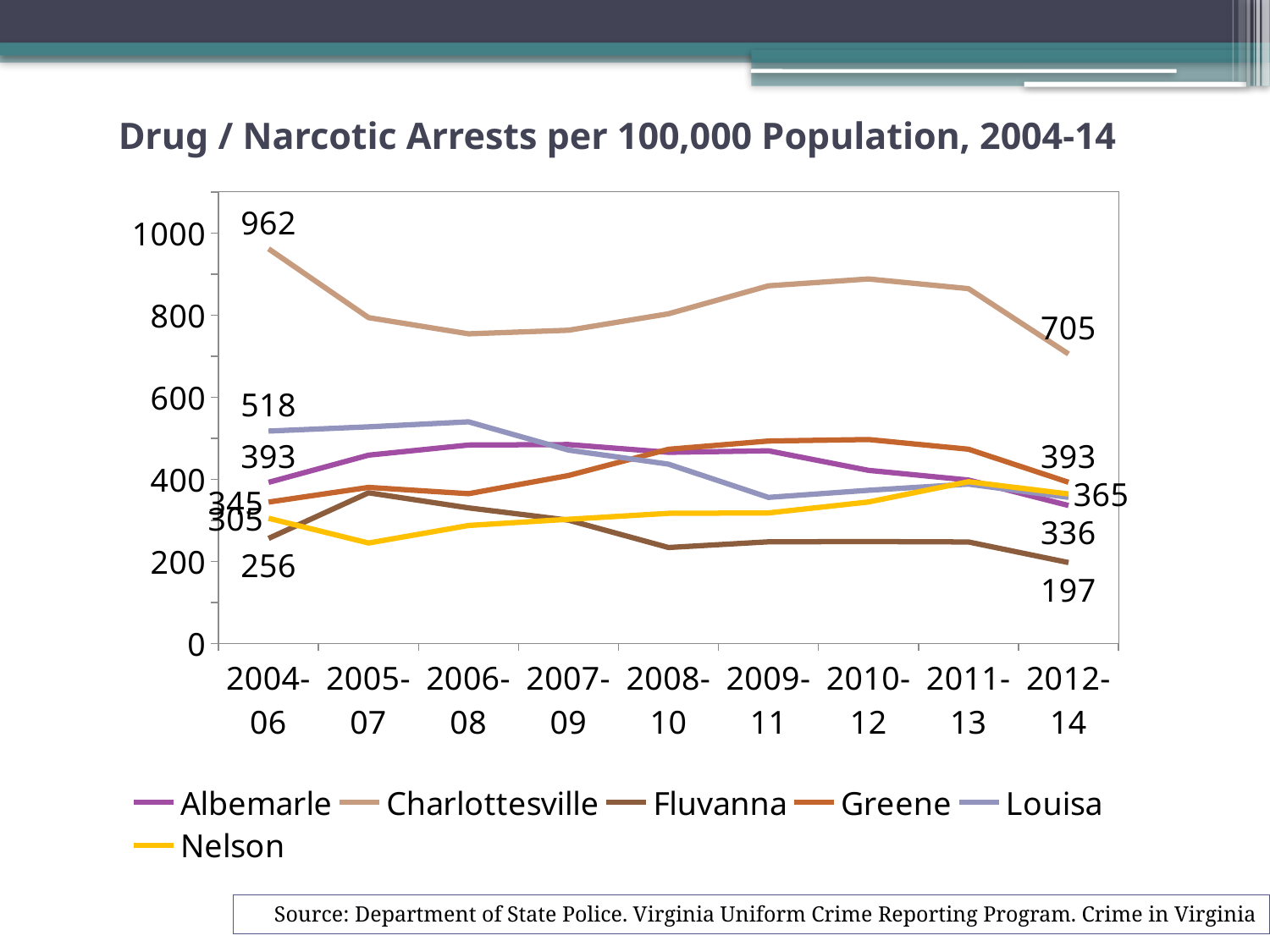
Is the value for Charlottesville in 2010-12 greater or less than 800? greater What is the value for Charlottesville in 2004-06? 962 What kind of chart is shown on the slide? line chart What is the value for Charlottesville in 2012-14? 705 What is the value for Fluvanna in 2004-06? 256 Which locality had the lowest value in 2012-14? Fluvanna What is the value for Fluvanna in 2012-14? 197 How many series does the legend list? 6 By how much did Charlottesville's value fall from 2004-06 to 2012-14? 257 What is the value for Louisa in 2004-06? 518 How many time periods are shown along the x axis? 9 Which locality had the highest value in 2004-06? Charlottesville